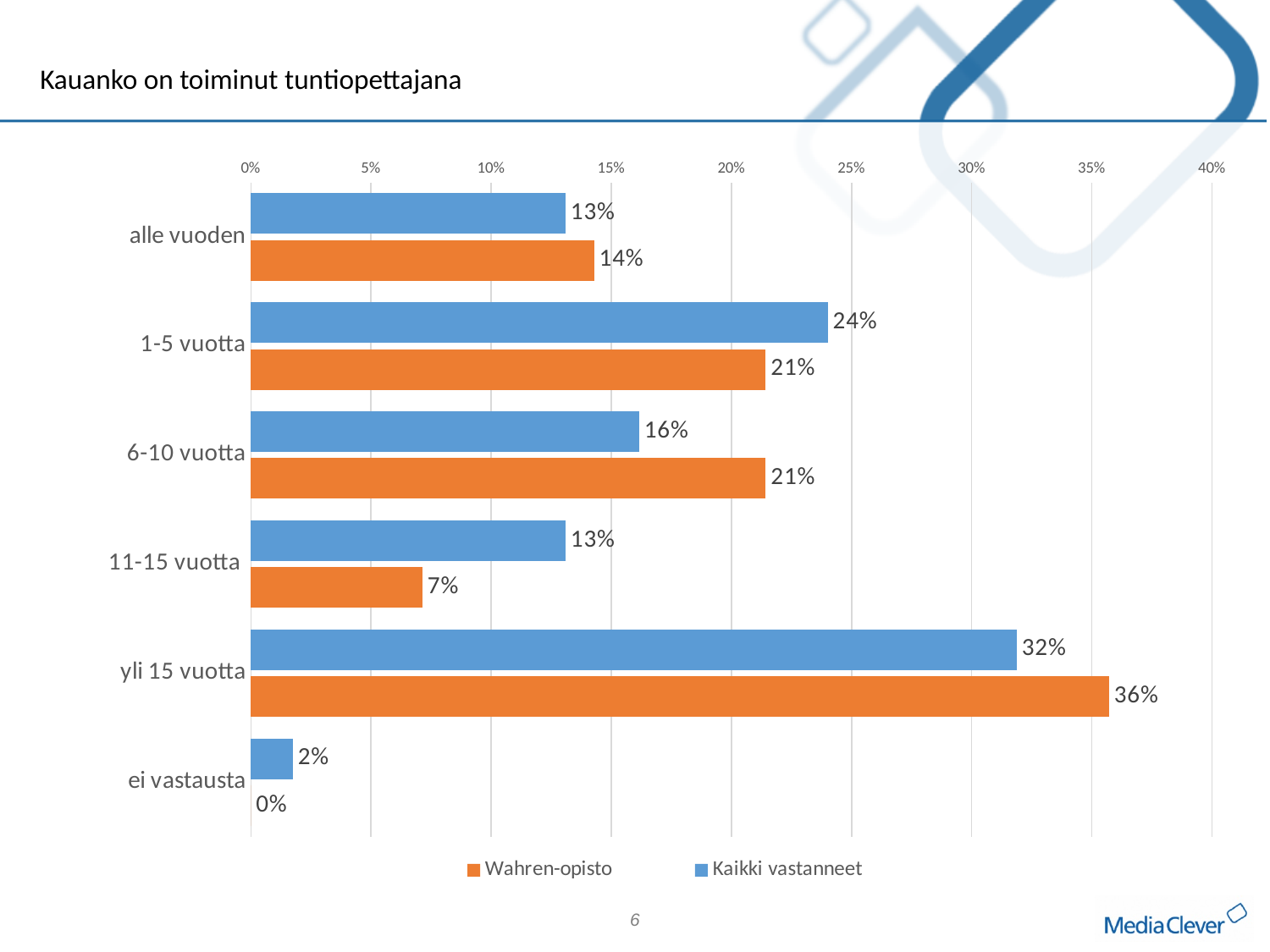
What is the value for Kaikki vastanneet in the '1-5 vuotta' category? 24% What is the value for Wahren-opisto in the 'yli 15 vuotta' category? 36% In the '11-15 vuotta' category, which series has the larger value, Wahren-opisto or Kaikki vastanneet? Kaikki vastanneet What kind of chart is shown on the slide? bar chart Which category has the highest value for Kaikki vastanneet? yli 15 vuotta What is the difference between Wahren-opisto and Kaikki vastanneet in the '6-10 vuotta' category? 5% What is the title of the chart? Kauanko on toiminut tuntiopettajana Which category has the lowest value for Wahren-opisto? ei vastausta Is the value for Wahren-opisto in 'yli 15 vuotta' greater or less than 35%? greater How many series does the legend list? 2 How many categories are shown on the chart? 6 What is the value for Wahren-opisto in the '11-15 vuotta' category? 7%